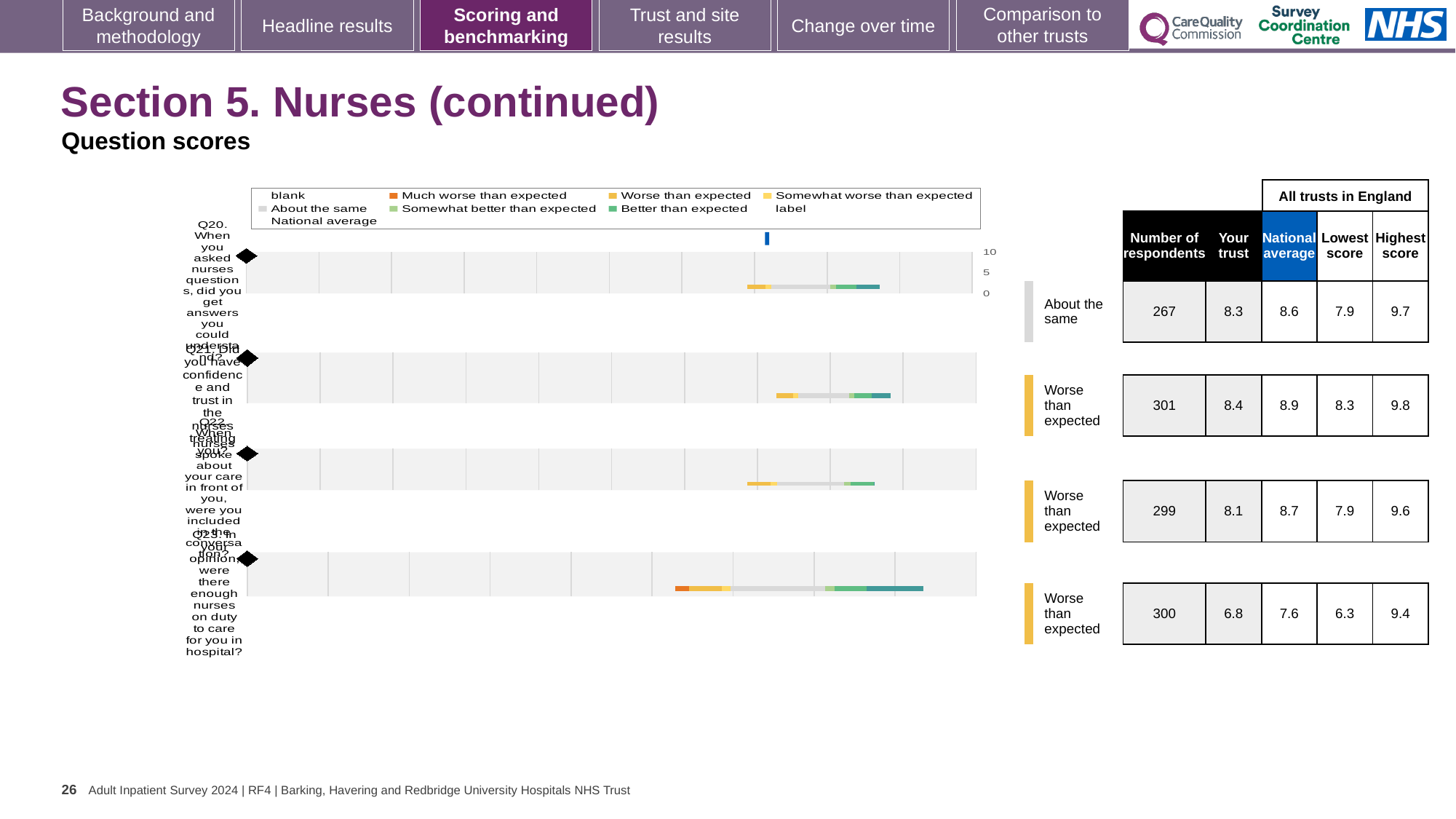
For Q23, what is the difference between the national average and the 'Your trust' score? 0.8 In the chart legend, which entry is shown in orange? Much worse than expected What is the 'Your trust' score for Q23 (were there enough nurses on duty to care for you in hospital)? 6.8 How many questions (Q20 to Q23) have a score bar plotted on the slide? 4 How many respondents answered Q20 (did you get answers you could understand)? 267 For Q20, which is larger: the 'Your trust' score or the national average? National average Which question has the lowest 'Your trust' score? Q23 What is the lowest score across all trusts in England for Q23? 6.3 Which question has the highest 'Your trust' score? Q21 What is the highest score across all trusts in England for Q22 (were you included in the conversation)? 9.6 What kind of chart is used to show the question scores for Q20 to Q23? bar chart What is the national average score for Q21 (confidence and trust in the nurses treating you)? 8.9